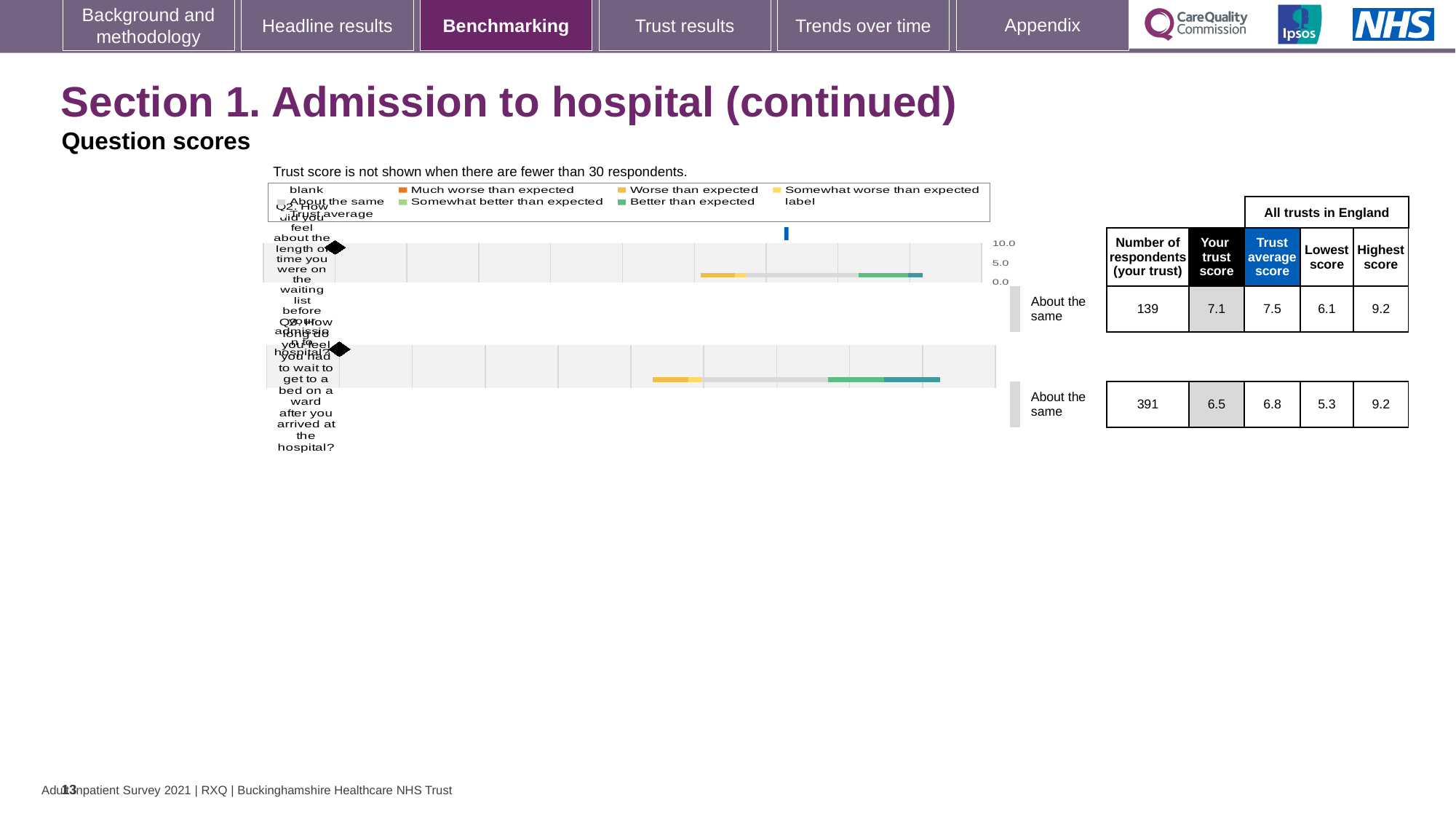
For the Q2 chart, what is the trust average score for all trusts in England? 7.5 For the Q3 chart, what is the difference between the highest and lowest scores across all trusts in England? 3.9 For the Q3 chart, is the trust score greater or less than the trust average score? less For the Q3 chart, what is the highest score among all trusts in England? 9.2 For the Q2 chart (length of time on the waiting list before admission), what is the trust score shown? 7.1 For the Q3 chart, what is the number of respondents for the trust? 391 For the Q3 chart (wait to get to a bed on a ward after arriving), what is the trust score shown? 6.5 What benchmark rating is shown next to the Q2 chart? About the same How many question charts are shown on the slide? 2 For the Q2 chart, what is the lowest score among all trusts in England? 6.1 Which question has the higher trust score, Q2 or Q3? Q2 For the Q2 chart, what is the difference between the trust average score and the trust's own score? 0.4